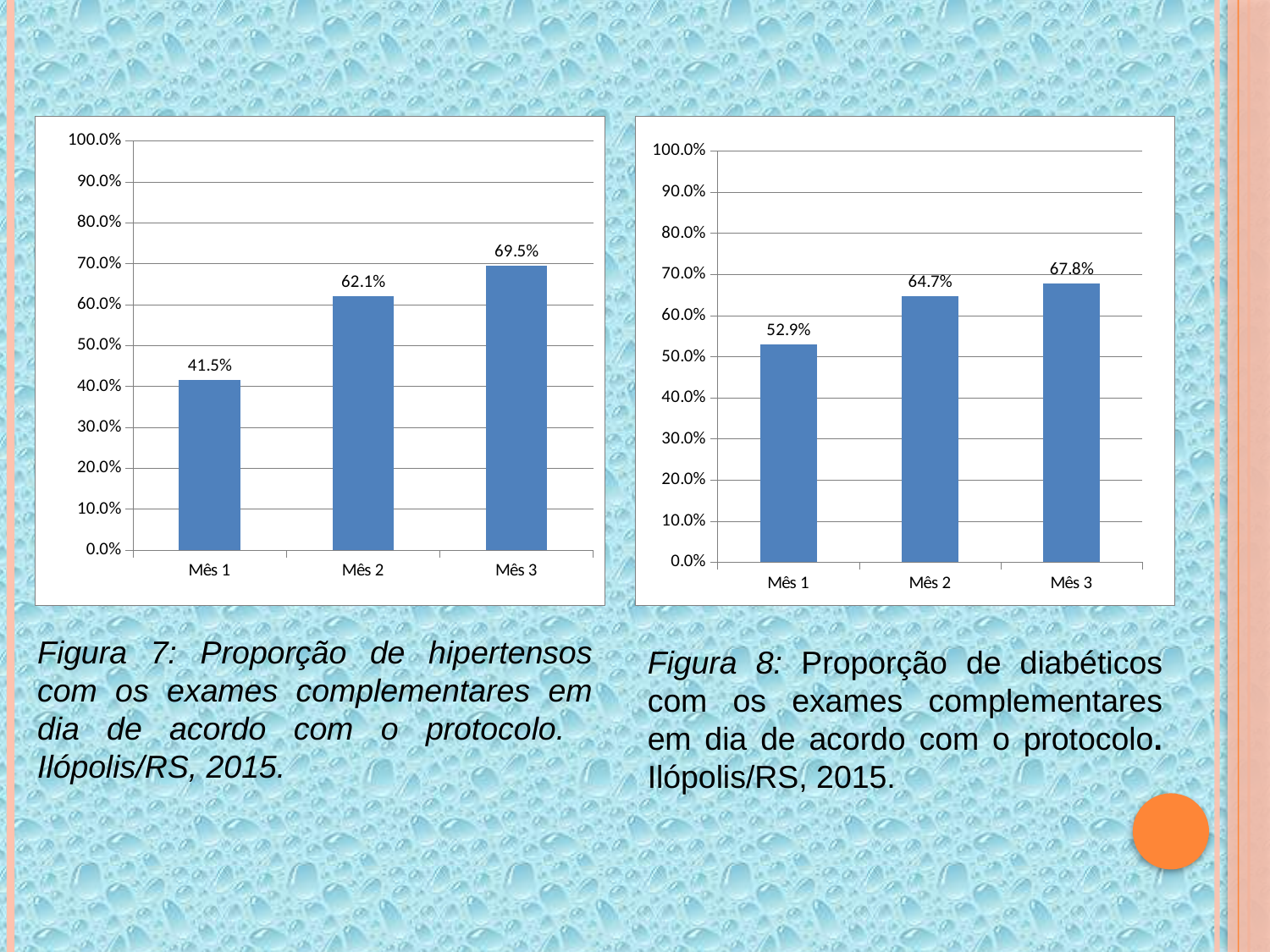
In the right chart (Figura 8, diabéticos), what is the value for Mês 1? 52.9% In the right chart (Figura 8, diabéticos), which month has the lowest value? Mês 1 In the left chart (Figura 7, hipertensos), how many months are plotted? 3 What kind of chart is the right chart (Figura 8, diabéticos)? Bar chart In the left chart (Figura 7, hipertensos), what is the difference between the values for Mês 2 and Mês 1? 20.6% In the left chart (Figura 7, hipertensos), what is the value for Mês 1? 41.5% In the right chart (Figura 8, diabéticos), what is the value for Mês 2? 64.7% In the left chart (Figura 7, hipertensos), which month has the highest value? Mês 3 In the right chart (Figura 8, diabéticos), what is the difference between the values for Mês 3 and Mês 2? 3.1% In the right chart (Figura 8, diabéticos), do the values rise or fall from Mês 1 to Mês 3? Rise Which is larger: the Mês 1 value in the left chart (Figura 7) or the Mês 1 value in the right chart (Figura 8)? Figura 8 (52.9%) In the left chart (Figura 7, hipertensos), what is the value for Mês 3? 69.5%